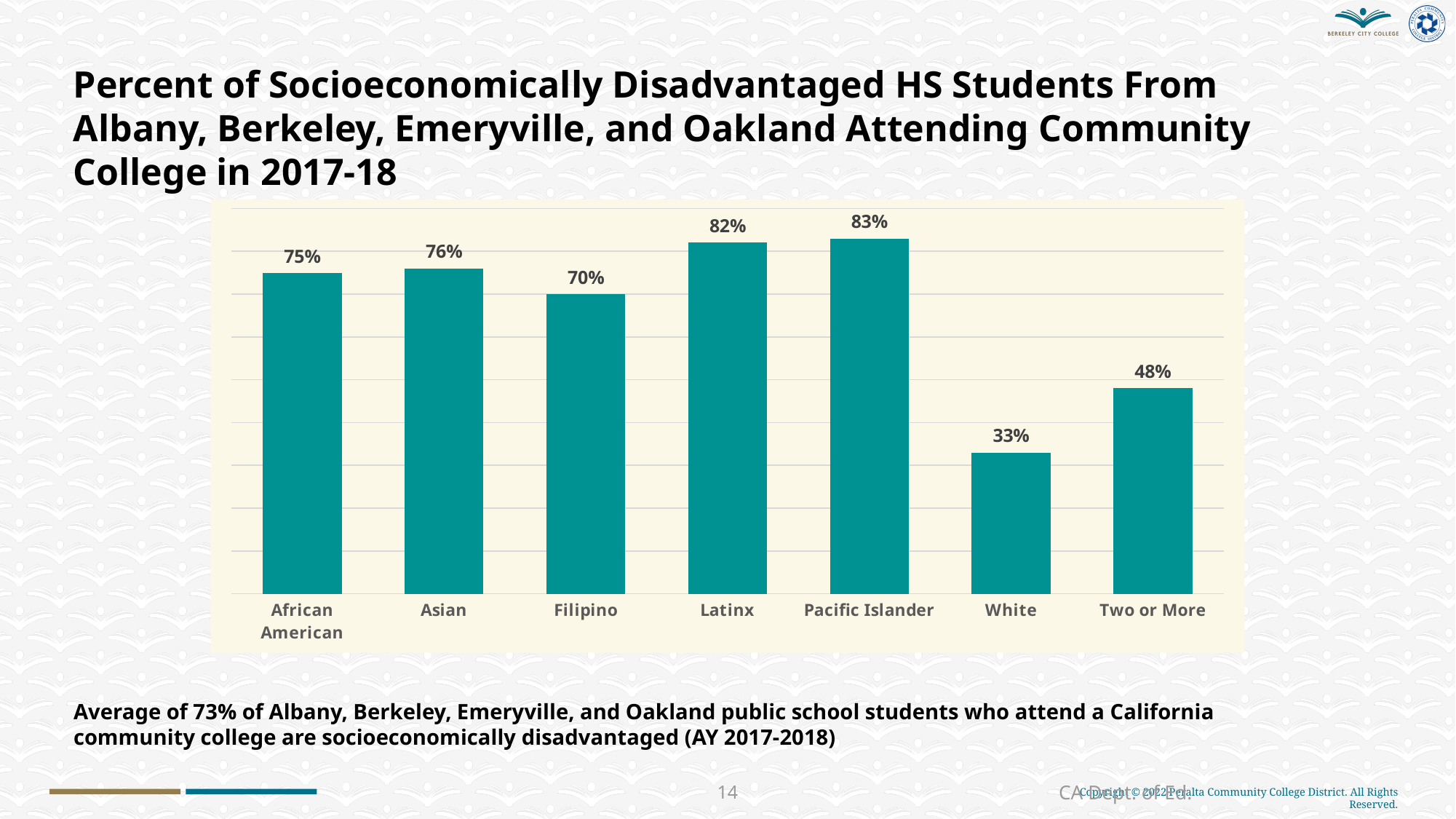
How many categories are shown in the chart? 7 What is the difference between the values for Asian and African American? 1% What is the value for Latinx? 82% Which category has the lowest value? White What kind of chart is shown on the slide? Bar chart What is the value for Filipino? 70% What is the value for Two or More? 48% Which is larger, the value for Filipino or the value for Two or More? Filipino What is the difference between the values for Pacific Islander and White? 50% Which category has the highest value? Pacific Islander What colour are the bars in the chart? Teal What is the value for White? 33%